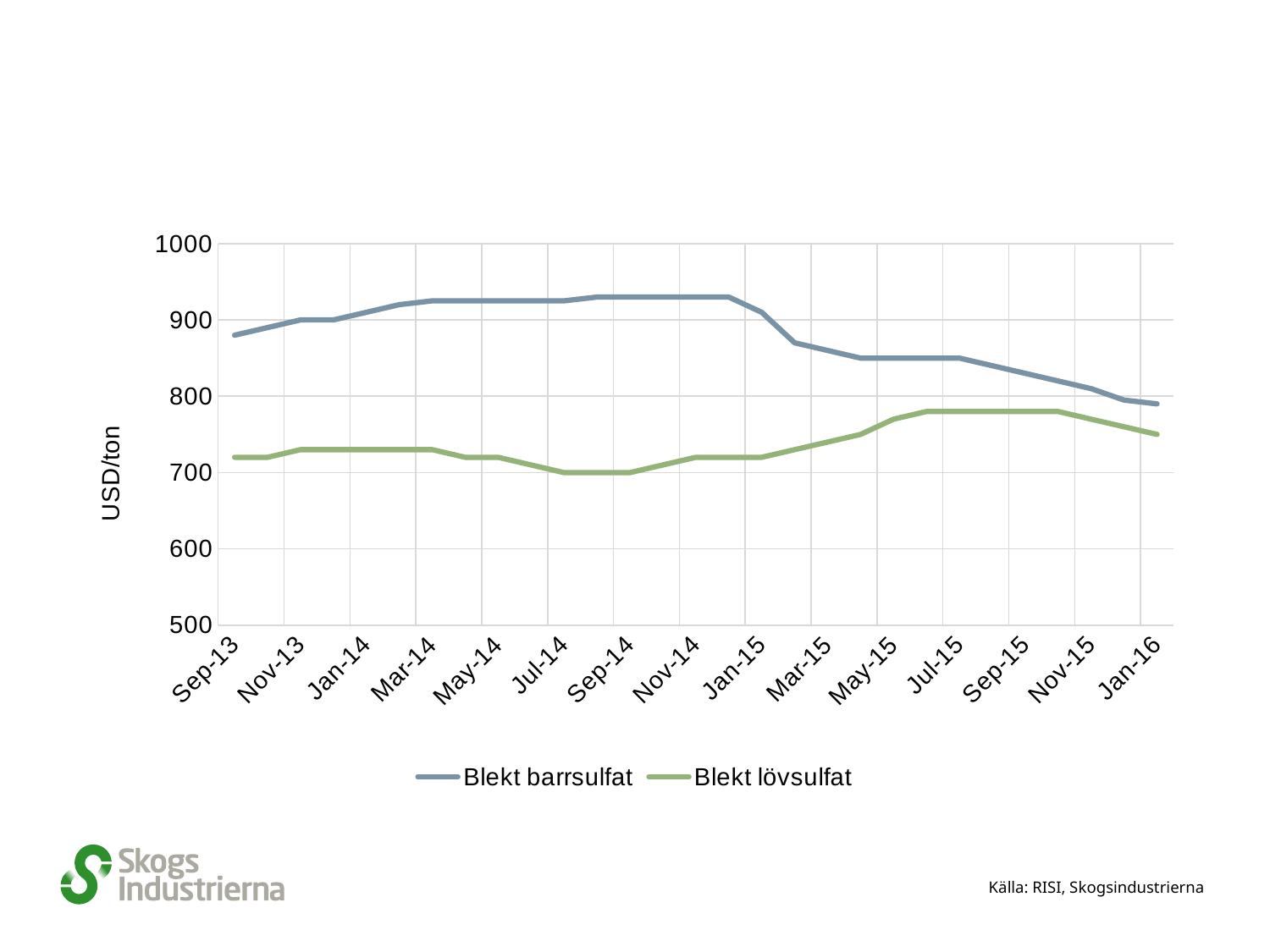
Which series has the higher value at Sep-13, Blekt barrsulfat or Blekt lövsulfat? Blekt barrsulfat How many series does the legend list? 2 How many date labels are shown on the x axis? 15 Is the value for Blekt lövsulfat at Sep-15 greater or less than 700? greater What is the label on the vertical axis? USD/ton Is the value for Blekt barrsulfat at Sep-13 greater or less than 800? greater What kind of chart is shown on the slide? line chart Which series is drawn in green? Blekt lövsulfat Does the Blekt lövsulfat line rise or fall from Sep-14 to Jul-15? rise Does the Blekt barrsulfat line rise or fall from Jan-15 to Jan-16? fall Is the value for Blekt lövsulfat at Jan-16 greater or less than 800? less